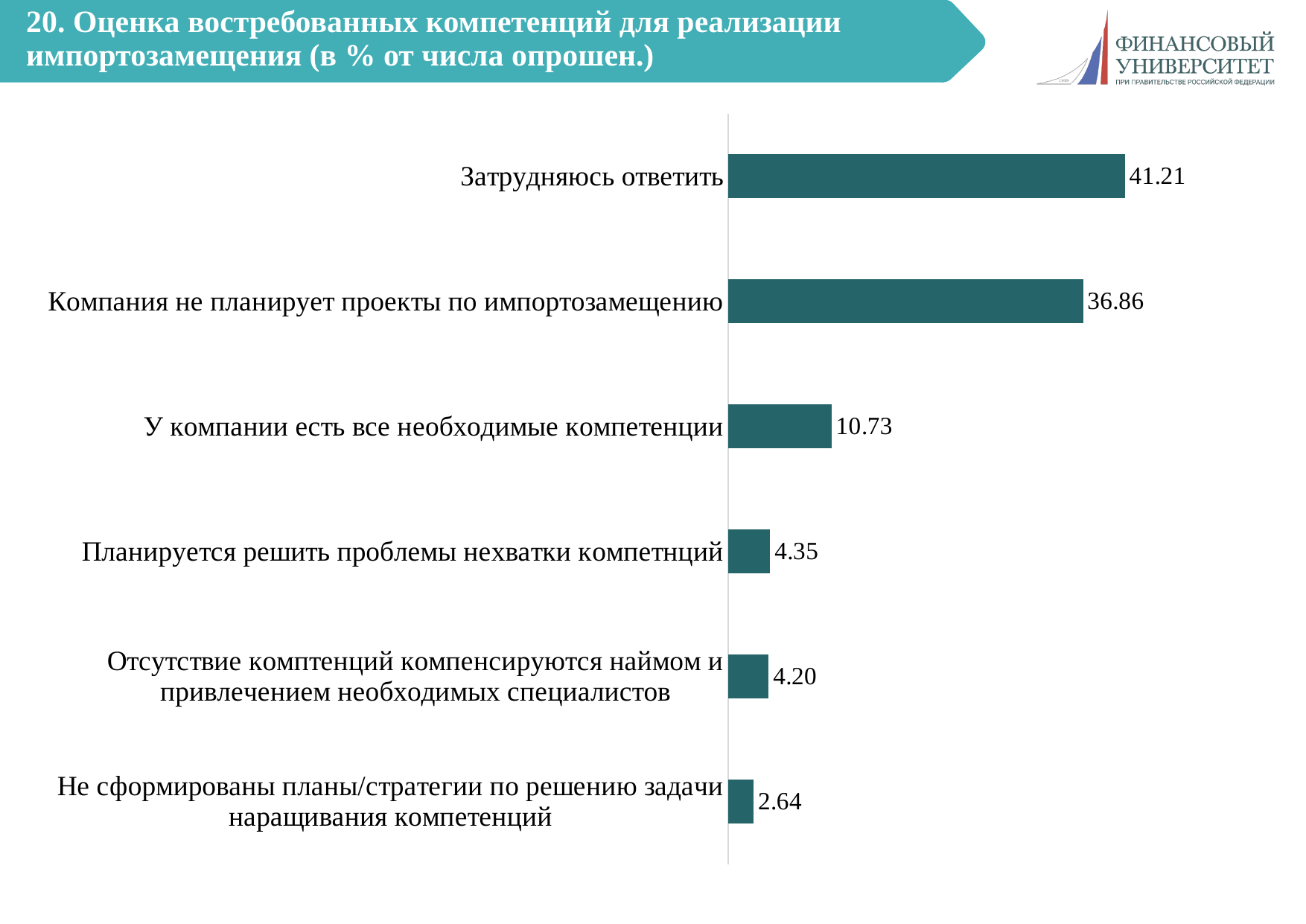
What is the value for "Затрудняюсь ответить"? 41.21 What is the value for "Компания не планирует проекты по импортозамещению"? 36.86 What is the difference between the values for "Затрудняюсь ответить" and "Компания не планирует проекты по импортозамещению"? 4.35 Which is larger: the value for "Планируется решить проблемы нехватки компетнций" or the value for "Не сформированы планы/стратегии по решению задачи наращивания компетенций"? Планируется решить проблемы нехватки компетнций What is the value for "Не сформированы планы/стратегии по решению задачи наращивания компетенций"? 2.64 What is the title of the slide? 20. Оценка востребованных компетенций для реализации импортозамещения (в % от числа опрошен.) Which category has the lowest value? Не сформированы планы/стратегии по решению задачи наращивания компетенций What kind of chart is shown on the slide? Bar chart What is the value for "У компании есть все необходимые компетенции"? 10.73 What is the difference between the values for "У компании есть все необходимые компетенции" and "Планируется решить проблемы нехватки компетнций"? 6.38 How many categories are shown in the chart? 6 Which category has the highest value? Затрудняюсь ответить